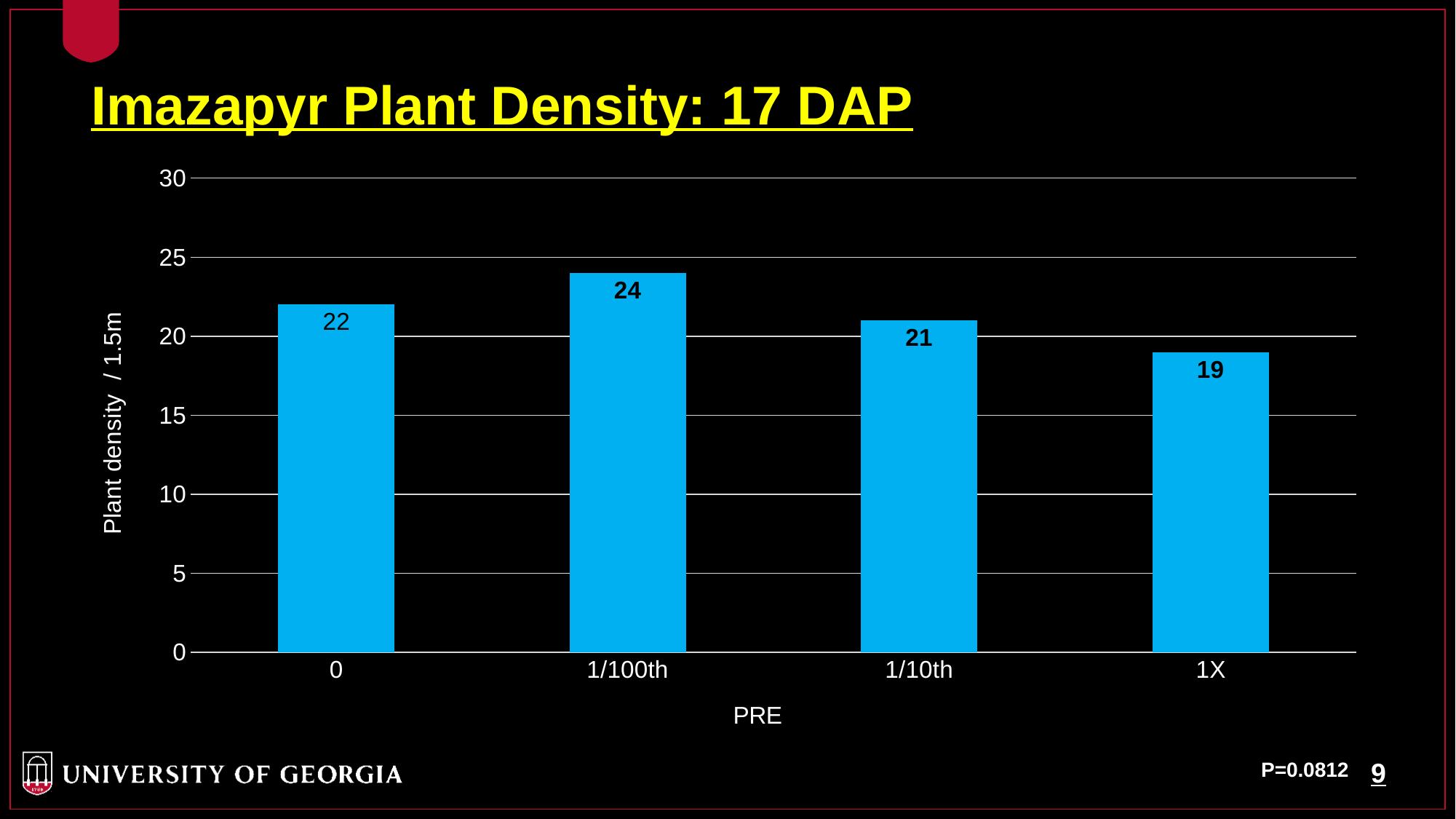
What is the title of the chart? Imazapyr Plant Density: 17 DAP What is the plant density for the 1/100th PRE rate? 24 What is the difference in plant density between the 1/100th and 1X rates? 5 What is the plant density for the 0 PRE rate? 22 How many PRE rate categories are shown on the chart? 4 Which has a higher plant density, the 0 rate or the 1/10th rate? 0 What is the label of the y axis? Plant density / 1.5m What is the plant density for the 1X PRE rate? 19 Is the plant density for the 1/10th rate greater or less than 25? less Which PRE rate has the highest plant density? 1/100th What kind of chart is shown on the slide? bar chart Which PRE rate has the lowest plant density? 1X